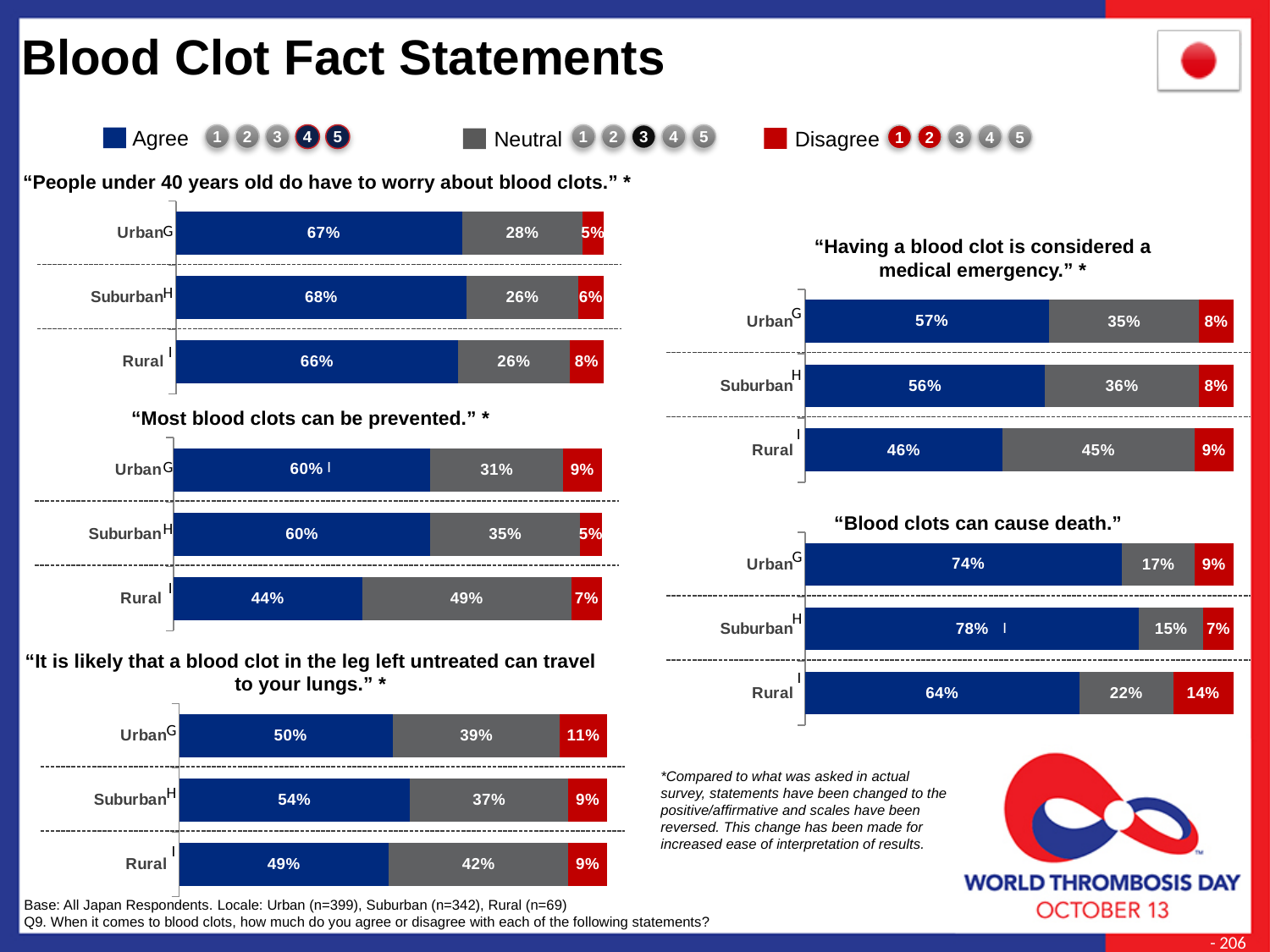
In the "Having a blood clot is considered a medical emergency." chart, what is the Disagree value for Rural? 9% In the "People under 40 years old do have to worry about blood clots." chart, which locale has the highest Agree percentage? Suburban In the "Blood clots can cause death." chart, which locale has the lowest Agree percentage? Rural In the "Having a blood clot is considered a medical emergency." chart, is the Neutral value larger for Rural or for Urban? Rural In the "Most blood clots can be prevented." chart, what is the Neutral value for Rural? 49% How many locale categories are shown in the "Blood clots can cause death." chart? 3 How many series does the legend at the top of the slide list? 3 In the "Blood clots can cause death." chart, what is the difference between the Rural and Suburban Disagree values? 7% In the "It is likely that a blood clot in the leg left untreated can travel to your lungs." chart, what is the difference between the Suburban and Urban Agree values? 4% In the "Most blood clots can be prevented." chart, is the Agree value larger for Urban or for Rural? Urban In the "Blood clots can cause death." chart, what percentage of Suburban respondents agree? 78% What kind of chart is the "Most blood clots can be prevented." chart? Stacked bar chart